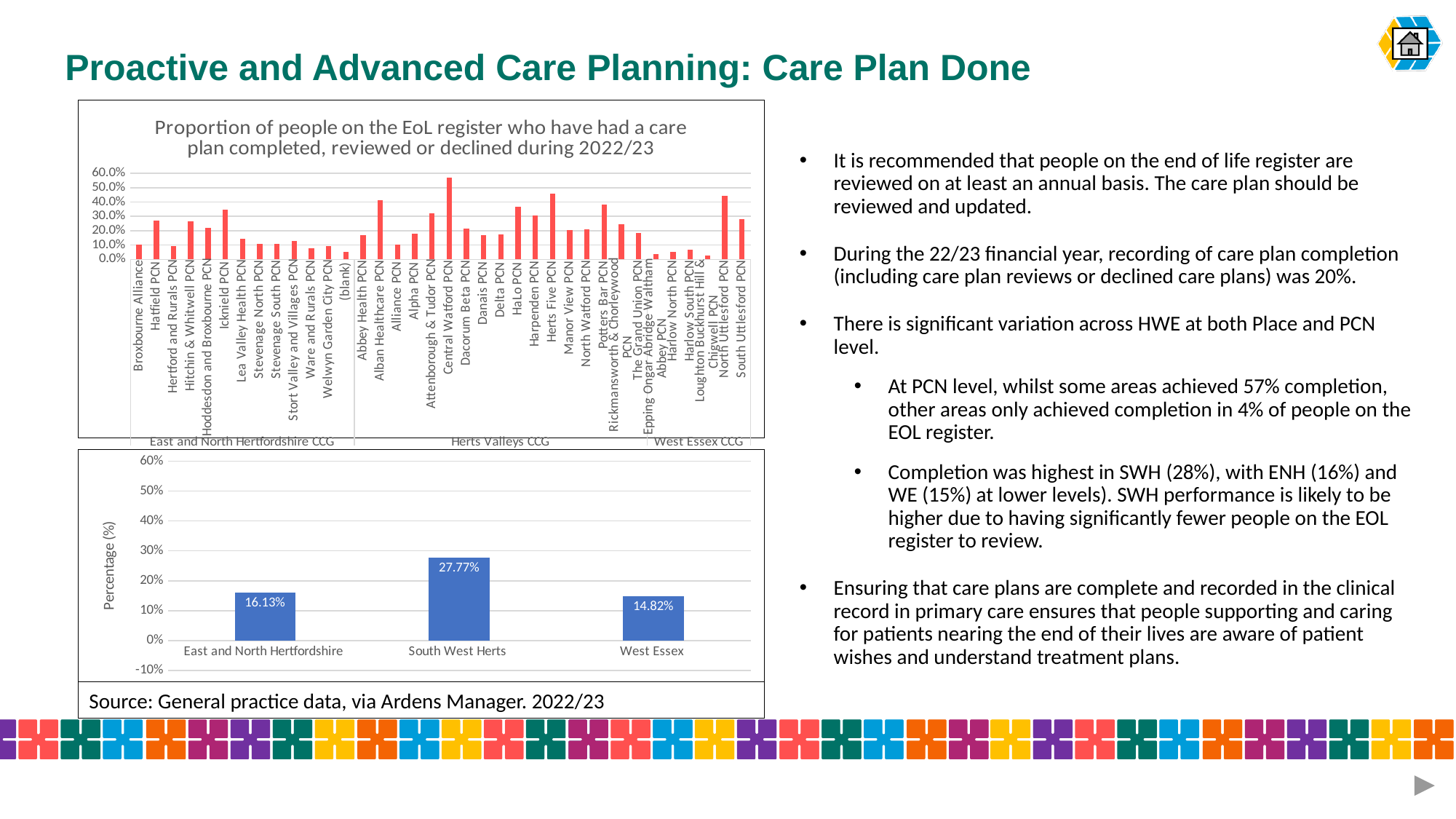
In the bottom chart, what is the difference between South West Herts and East and North Hertfordshire? 11.64% What kind of chart is the top chart titled 'Proportion of people on the EoL register who have had a care plan completed, reviewed or declined during 2022/23'? Bar chart In the bottom chart, what is the value for East and North Hertfordshire? 16.13% In the bottom chart, what is the value for South West Herts? 27.77% In the bottom chart, how many areas are plotted? 3 In the bottom chart, what is the difference between East and North Hertfordshire and West Essex? 1.31% In the bottom chart, which area has the highest percentage? South West Herts In the bottom chart, what is the value for West Essex? 14.82% In the top chart, which PCN has the highest proportion? Central Watford PCN In the top chart, is the value for Central Watford PCN greater or less than 50.0%? greater In the top chart, is the value for Herts Five PCN greater or less than 40.0%? greater In the bottom chart, which area has the lowest percentage? West Essex